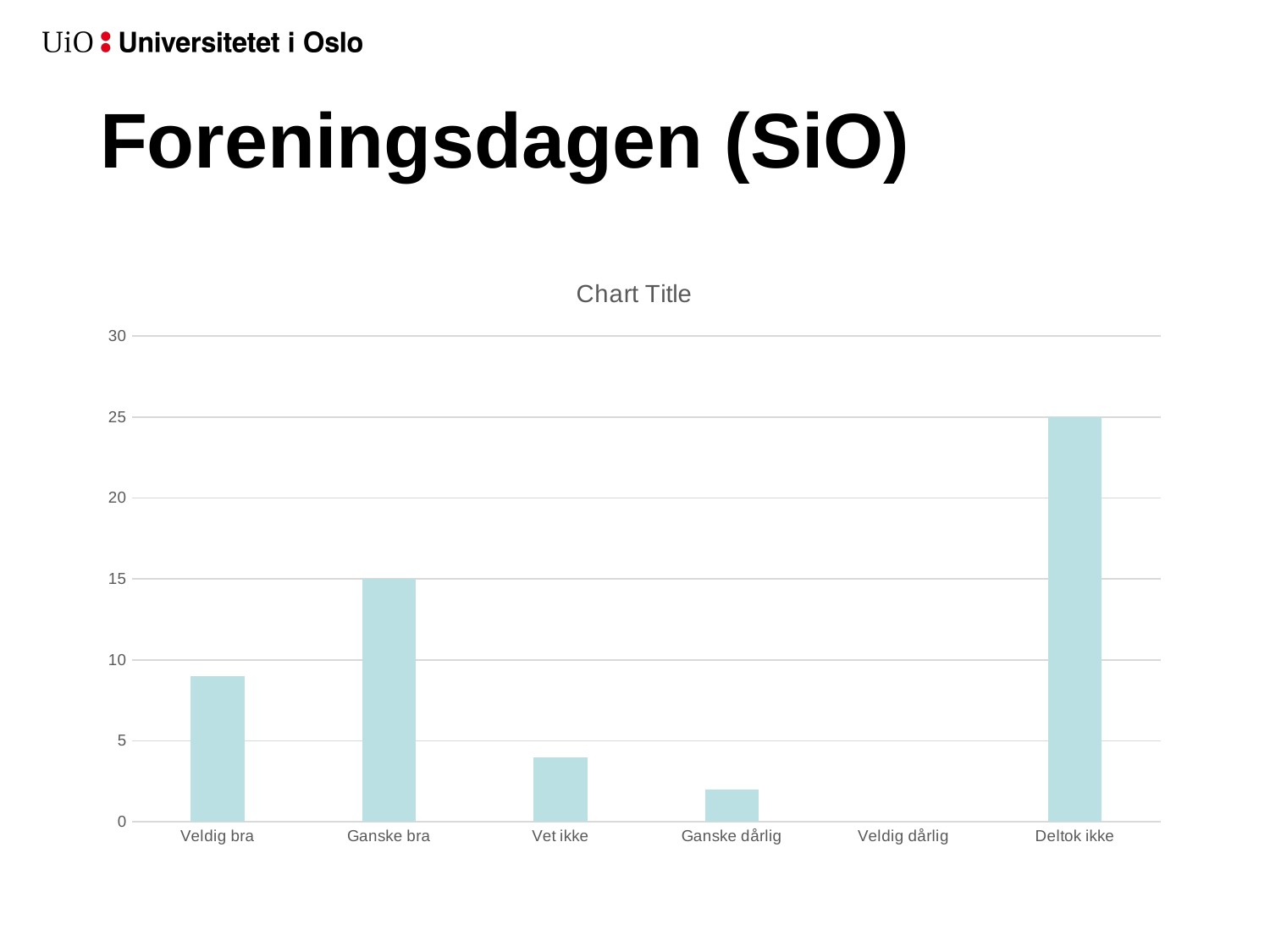
Which is larger, the value for Ganske bra or the value for Veldig bra? Ganske bra What is the value for Veldig dårlig? 0 How many categories are shown on the x axis of the chart? 6 What is the value for Ganske bra? 15 Which category has the highest bar in the chart? Deltok ikke What is the value for Deltok ikke? 25 What is the title shown above the chart? Chart Title What kind of chart is shown on the slide? bar chart Which category has the lowest value in the chart? Veldig dårlig What is the difference between the values for Deltok ikke and Ganske bra? 10 Is the value for Vet ikke greater or less than 5? less Is the value for Veldig bra greater or less than 10? less